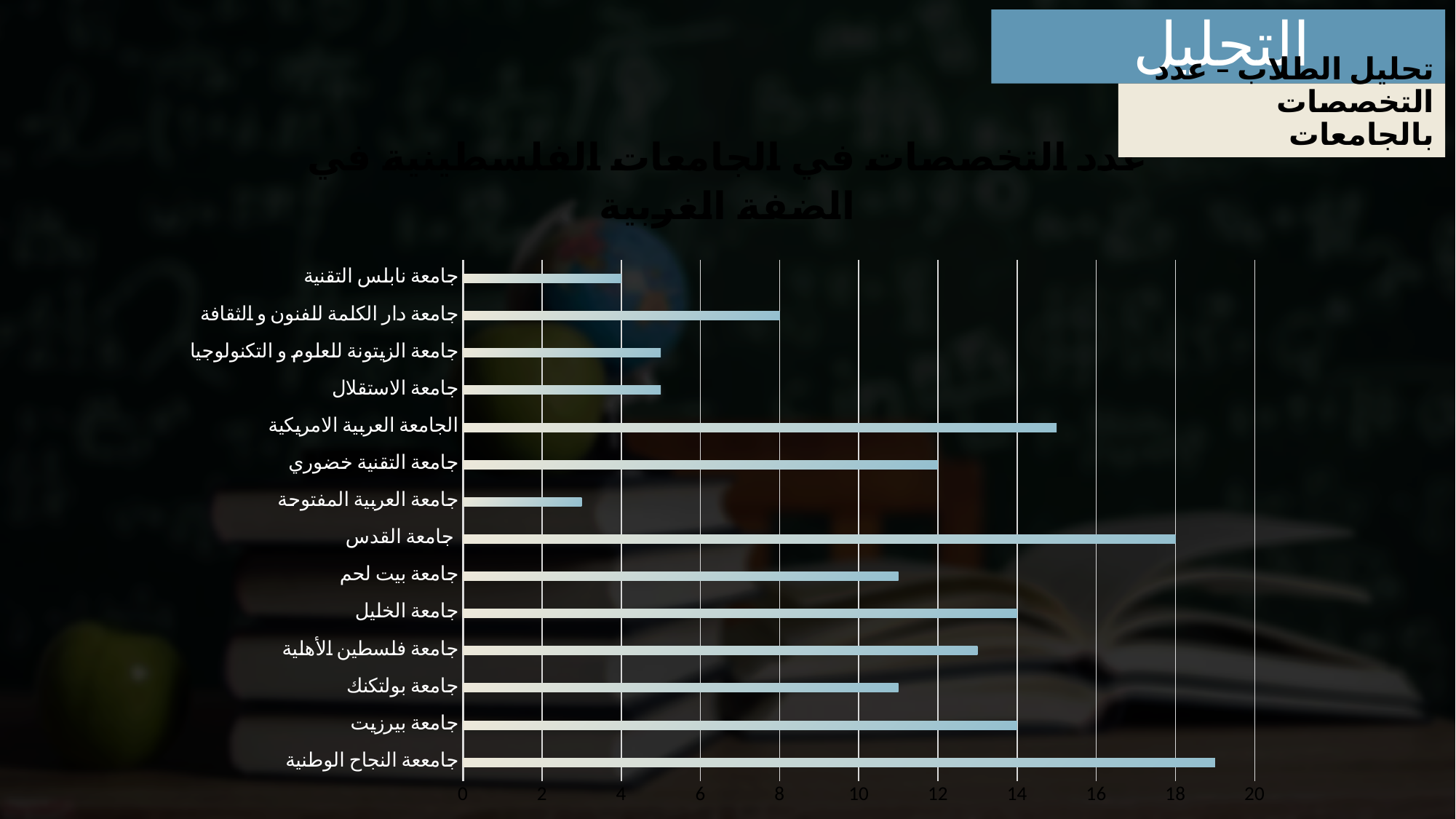
How many universities are listed on the chart? 14 What type of chart is shown on the slide? Bar chart Is the value for الجامعة العربية الامريكية greater or less than 14? greater What is the value for جامعة نابلس التقنية? 4 Which university has the highest value on the chart? جامعة النجاح الوطنية What is the value for جامعة التقنية خضوري? 12 What is the difference between the values for جامعة القدس and جامعة الخليل? 4 What is the value for جامعة القدس? 18 Which has a larger value, جامعة بيرزيت or جامعة التقنية خضوري? جامعة بيرزيت Which university has the lowest value on the chart? جامعة العربية المفتوحة What is the value for جامعة دار الكلمة للفنون والثقافة? 8 Is the value for جامعة الزيتونة للعلوم والتكنولوجيا greater or less than 6? less